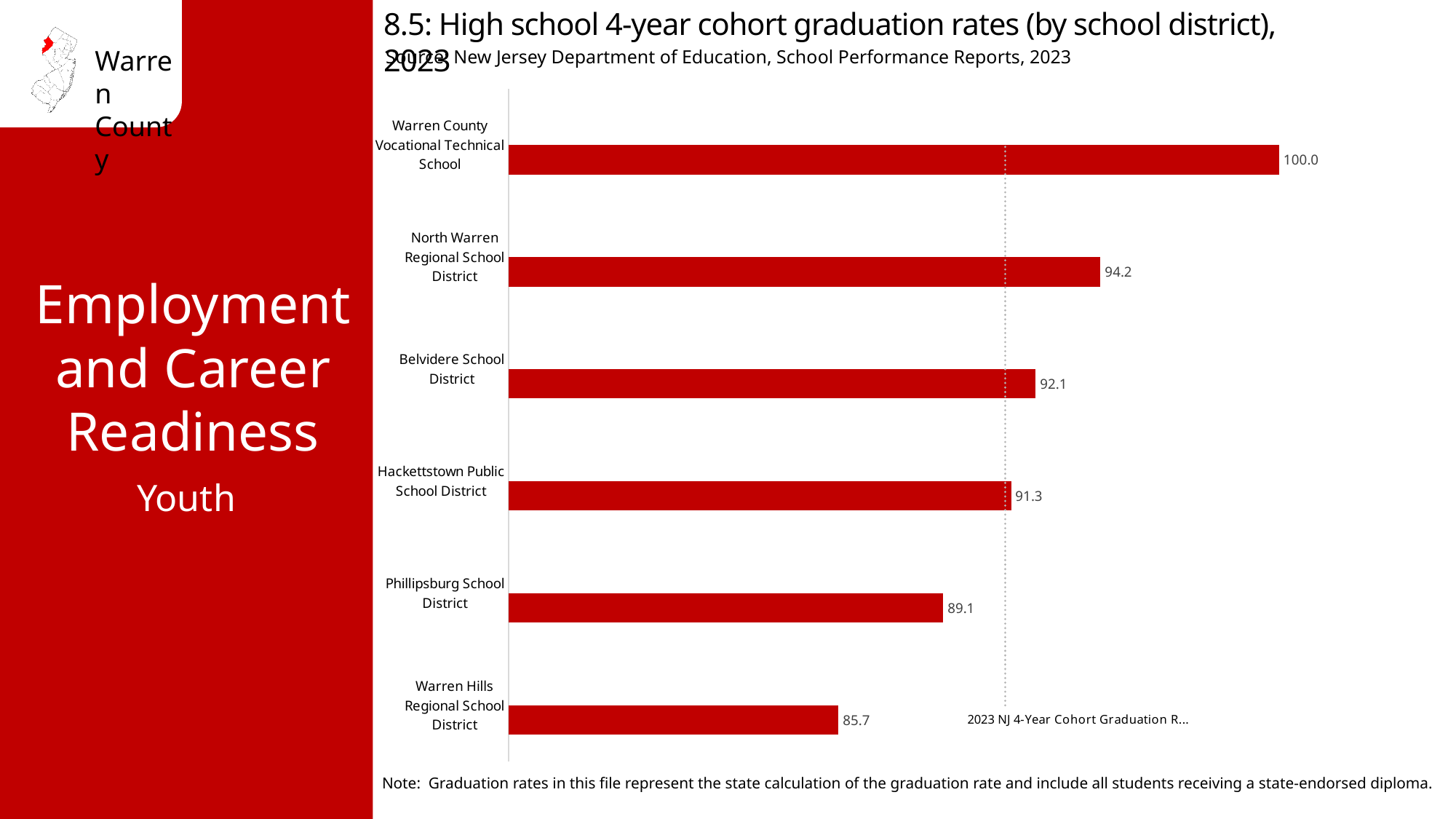
What is the source cited for the chart data? New Jersey Department of Education, School Performance Reports, 2023 How many school districts are shown on the chart? 6 What is the difference between the graduation rates of North Warren Regional School District and Belvidere School District? 2.1 What is the difference between the graduation rates of Warren County Vocational Technical School and Warren Hills Regional School District? 14.3 What is the 4-year cohort graduation rate for Warren County Vocational Technical School? 100.0 Which has a higher graduation rate, Belvidere School District or Phillipsburg School District? Belvidere School District What does the dotted vertical line on the chart represent? 2023 NJ 4-Year Cohort Graduation Rate Which school district has the highest graduation rate on the chart? Warren County Vocational Technical School What is the graduation rate shown for Hackettstown Public School District? 91.3 What kind of chart is used on this slide? Bar chart What is the graduation rate shown for Phillipsburg School District? 89.1 Which school district has the lowest graduation rate on the chart? Warren Hills Regional School District